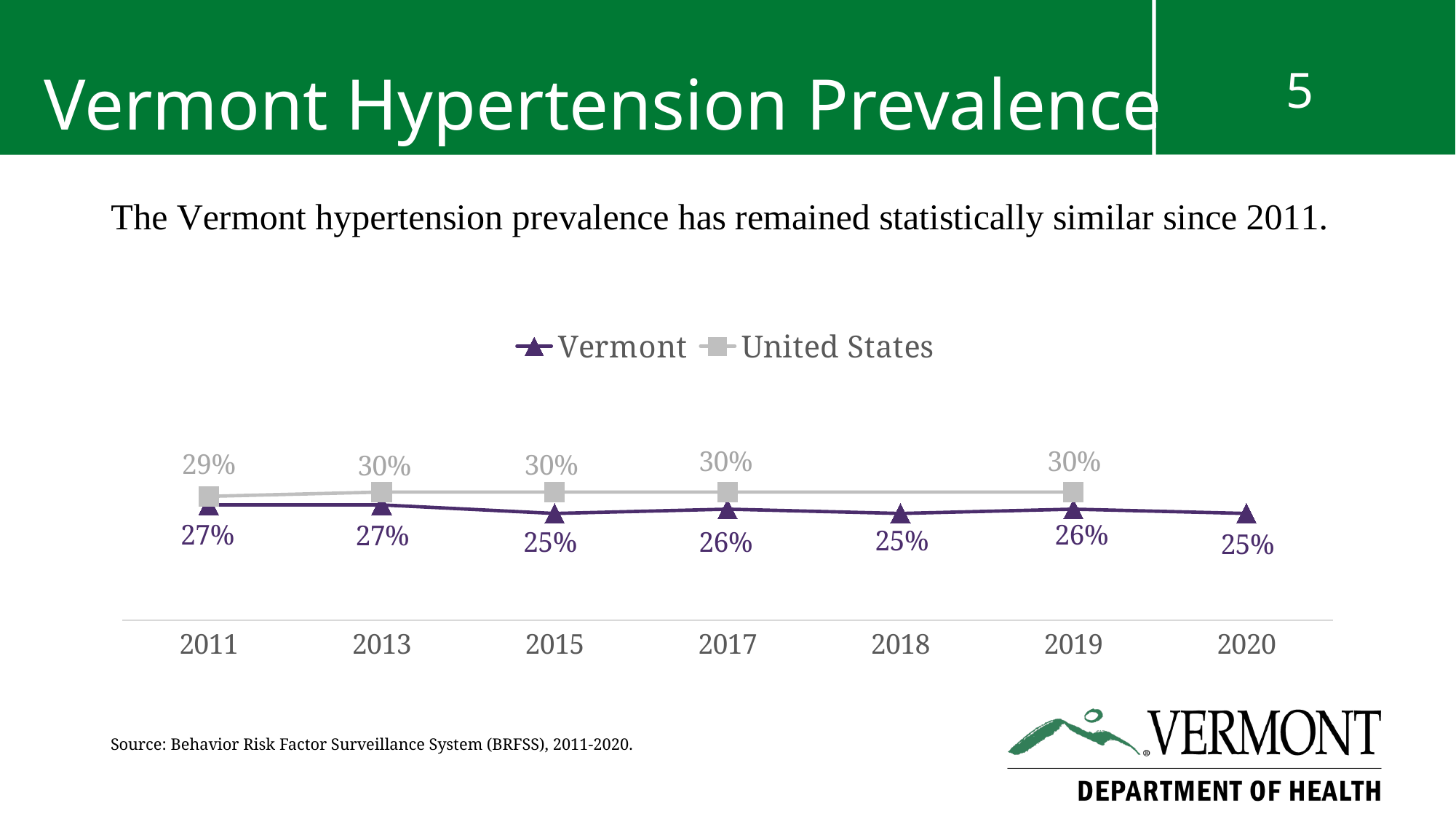
In which year is the United States value lowest? 2011 What is the Vermont value for 2017? 26% How many series does the legend list? 2 What is the difference between the United States and Vermont values in 2015? 5% What is the Vermont value for 2020? 25% What type of chart is shown on the slide? line chart How many years are shown on the x axis? 7 Which series has the higher value in 2019, Vermont or United States? United States What is the difference between the United States and Vermont values in 2011? 2% What is the Vermont hypertension prevalence in 2011? 27% What is the United States hypertension prevalence in 2013? 30% Which series is plotted with triangle markers? Vermont